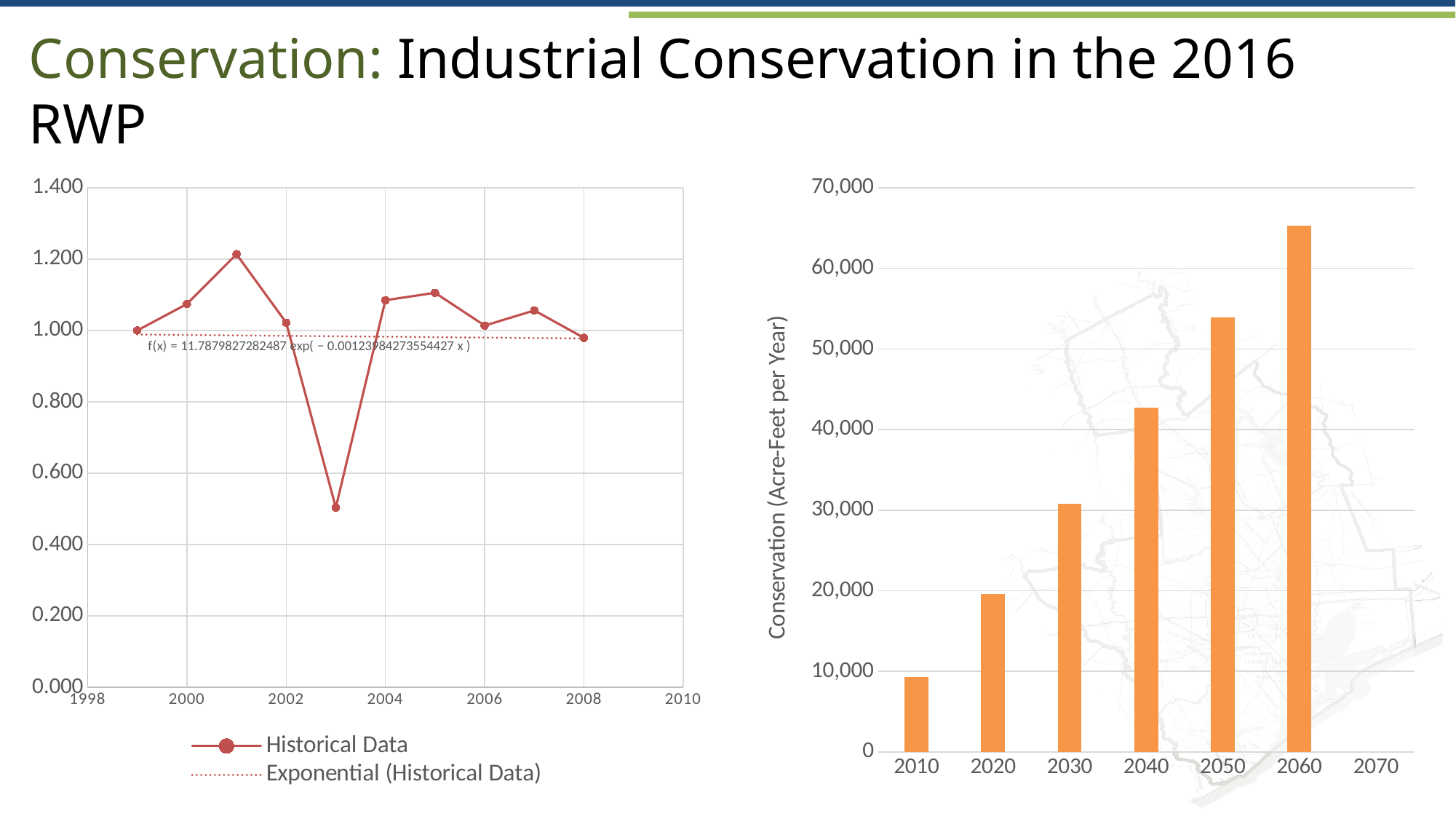
On the right bar chart, is the value for 2040 greater or less than 40,000? greater On the right bar chart, is the value for 2010 greater or less than 10,000? less On the right bar chart, do the values rise or fall from 2010 to 2060? rise What is the y-axis title of the right bar chart? Conservation (Acre-Feet per Year) On the left line chart, which year has the highest Historical Data value? 2001 How many bars are plotted on the right bar chart? 6 On the left line chart, which year has the lowest Historical Data value? 2003 How many entries does the legend of the left line chart list? 2 On the right bar chart, which year has the highest conservation value? 2060 What kind of chart is the chart on the right of the slide? bar chart On the right bar chart, is the value for 2060 greater or less than 60,000? greater On the right bar chart, which year has the lowest conservation value? 2010